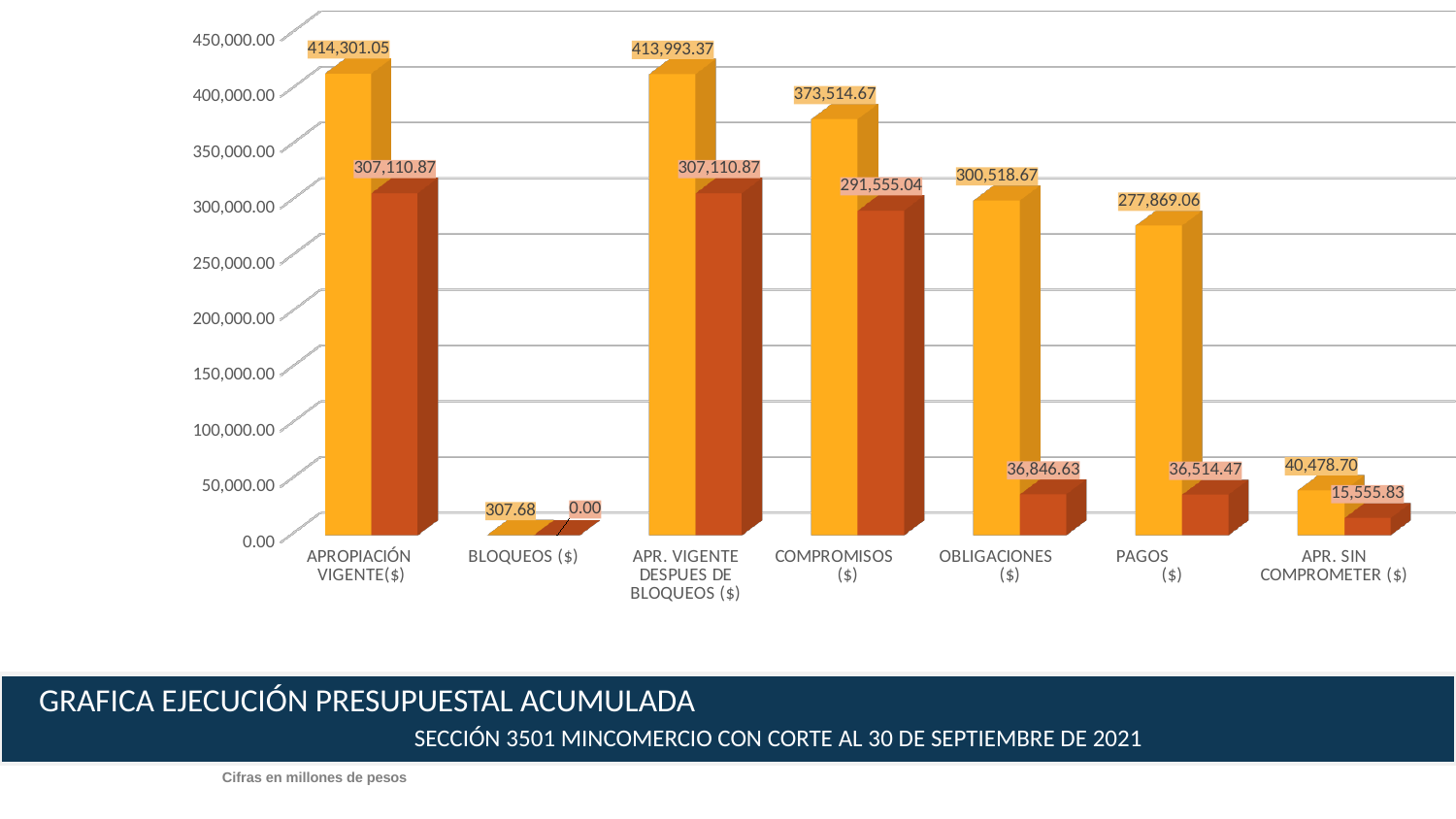
Which category has the highest yellow bar? APROPIACIÓN VIGENTE($) Which is larger, the dark orange bar for OBLIGACIONES ($) or the dark orange bar for APR. SIN COMPROMETER ($)? OBLIGACIONES ($) What is the value of the yellow bar for PAGOS ($)? 277,869.06 What is the difference between the yellow and dark orange bars for COMPROMISOS ($)? 81,959.63 What is the value of the yellow bar for APROPIACIÓN VIGENTE($)? 414,301.05 What is the value of the dark orange bar for COMPROMISOS ($)? 291,555.04 What kind of chart is shown on the slide? bar chart Is the yellow bar for OBLIGACIONES ($) greater or less than 250,000.00? greater What is the value of the dark orange bar for BLOQUEOS ($)? 0.00 Which category has the lowest yellow bar? BLOQUEOS ($) How many categories are shown on the x axis? 7 What is the difference between the yellow bars for APROPIACIÓN VIGENTE($) and APR. VIGENTE DESPUES DE BLOQUEOS ($)? 307.68